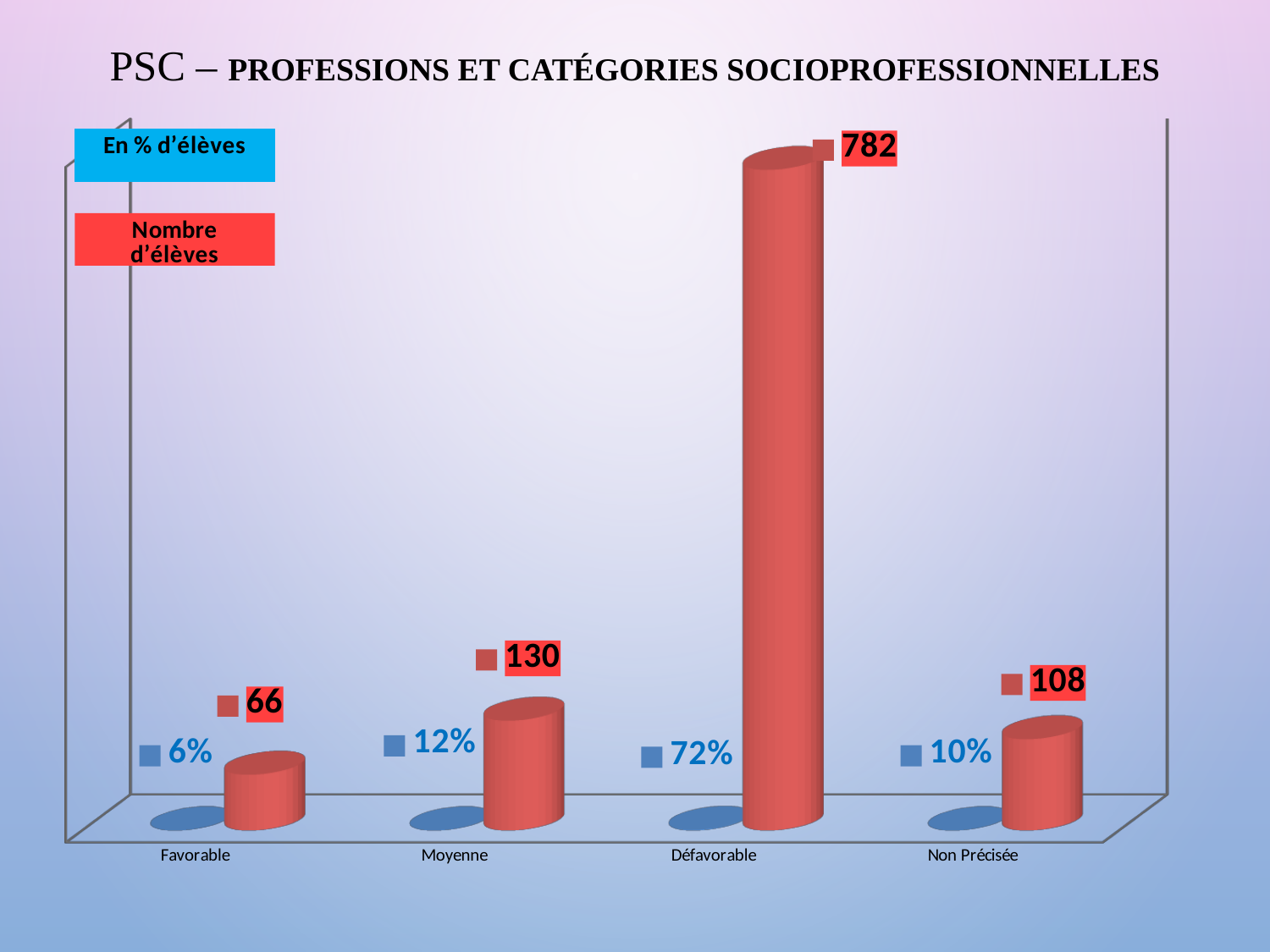
Which colour represents the series 'Nombre d'élèves' in the legend? Red Which category has the highest number of students? Défavorable What kind of chart is shown on the slide? Bar chart How many categories are shown on the x axis? 4 What is the number of students (Nombre d'élèves) for the Défavorable category? 782 What is the number of students (Nombre d'élèves) for the Favorable category? 66 Which has a larger number of students, Moyenne or Non Précisée? Moyenne Which category has the lowest number of students? Favorable What is the difference in number of students between Moyenne and Non Précisée? 22 What percentage of students is shown for the Non Précisée category? 10% How many series does the legend list? 2 What percentage of students (En % d'élèves) is shown for the Moyenne category? 12%